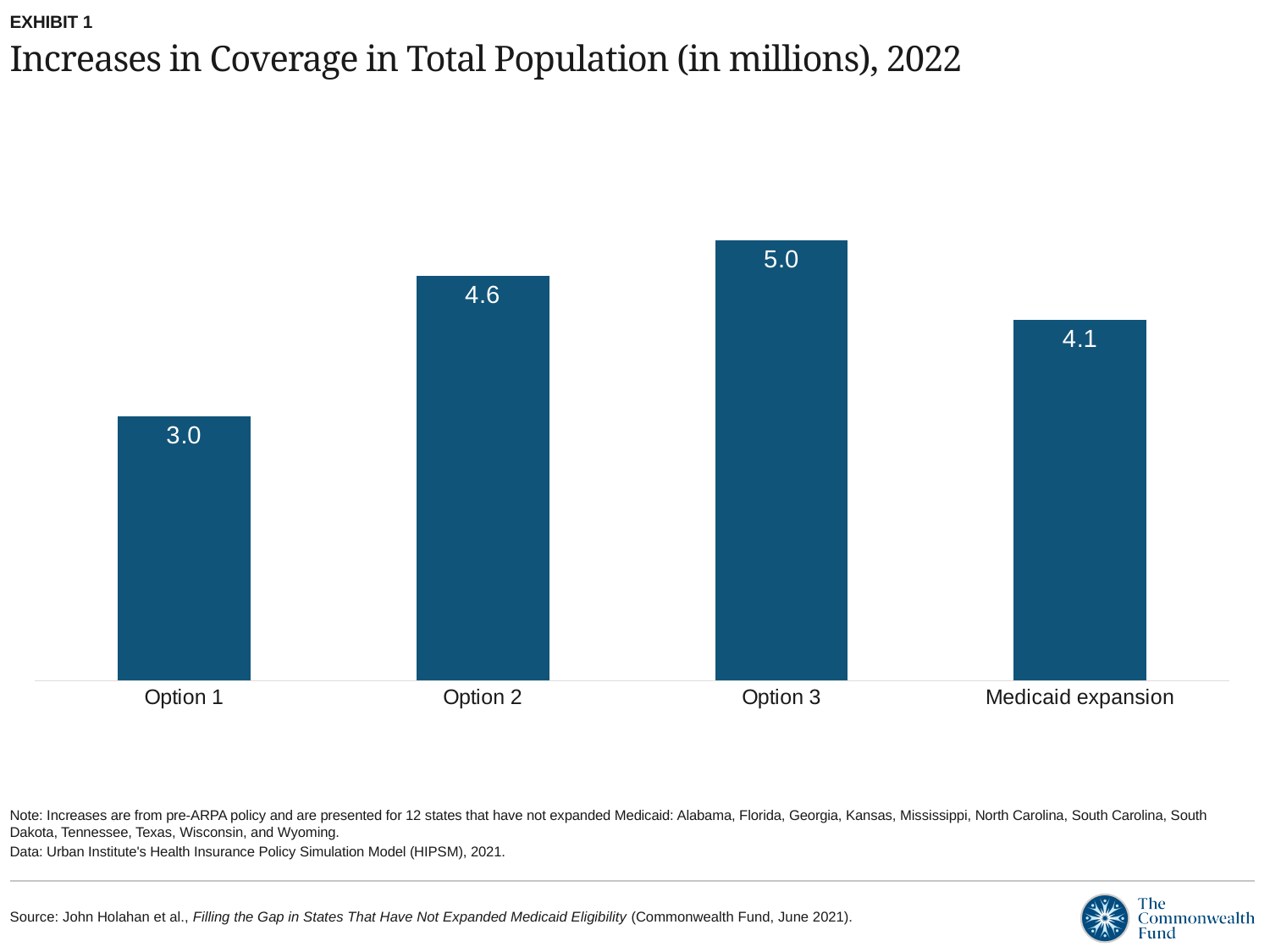
What is the value for Option 2? 4.6 How many categories are shown in the chart? 4 Which category has the highest value? Option 3 What is the value for Option 1? 3.0 What kind of chart is shown on the slide? Bar chart What is the difference between the values for Option 2 and Medicaid expansion? 0.5 What is the difference between the values for Option 3 and Option 1? 2.0 What is the title of the chart? Increases in Coverage in Total Population (in millions), 2022 What is the value for Medicaid expansion? 4.1 What is the value for Option 3? 5.0 Which is larger, the value for Option 2 or the value for Medicaid expansion? Option 2 Which category has the lowest value? Option 1